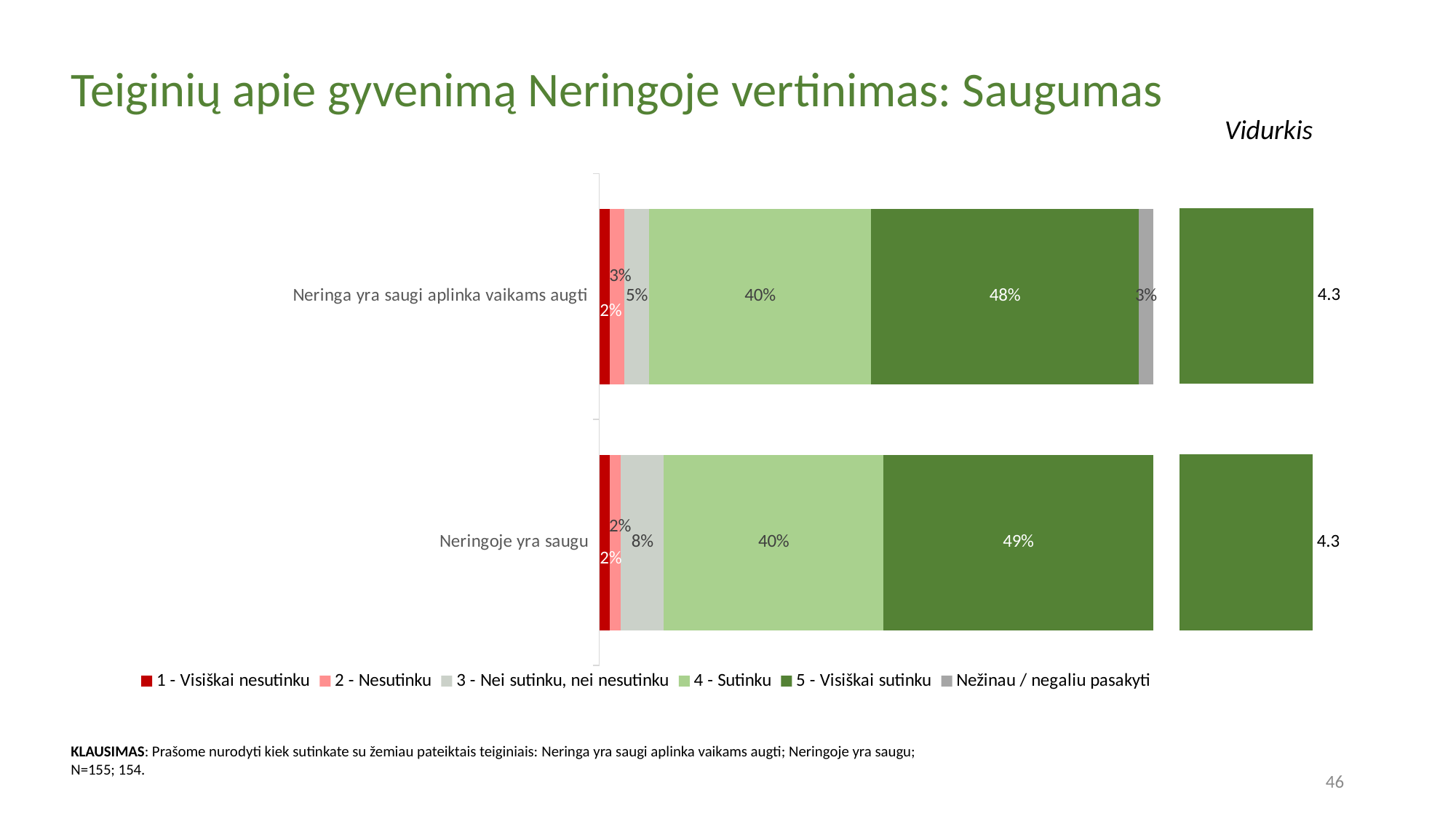
In the stacked bar chart, what percentage of respondents chose "5 - Visiškai sutinku" for "Neringoje yra saugu"? 49% In the stacked bar chart, what is the difference in the "3 - Nei sutinku, nei nesutinku" share between "Neringoje yra saugu" and "Neringa yra saugi aplinka vaikams augti"? 3 percentage points In the stacked bar chart, what is the "Nežinau / negaliu pasakyti" share for "Neringa yra saugi aplinka vaikams augti"? 3% How many statements (categories) are shown in the stacked bar chart? 2 In the stacked bar chart, which statement has the larger "5 - Visiškai sutinku" share? Neringoje yra saugu How many series does the legend of the stacked bar chart list? 6 In the "Vidurkis" chart on the right, what is the average value for "Neringoje yra saugu"? 4.3 In the stacked bar chart, what is the value of "3 - Nei sutinku, nei nesutinku" for "Neringoje yra saugu"? 8% In the stacked bar chart, what percentage chose "4 - Sutinku" for "Neringa yra saugi aplinka vaikams augti"? 40% What type of chart is used to show the response distribution on this slide? Stacked bar chart In the stacked bar chart, which response category has the largest share for "Neringa yra saugi aplinka vaikams augti"? 5 - Visiškai sutinku In the stacked bar chart legend, what colour represents "1 - Visiškai nesutinku"? Dark red